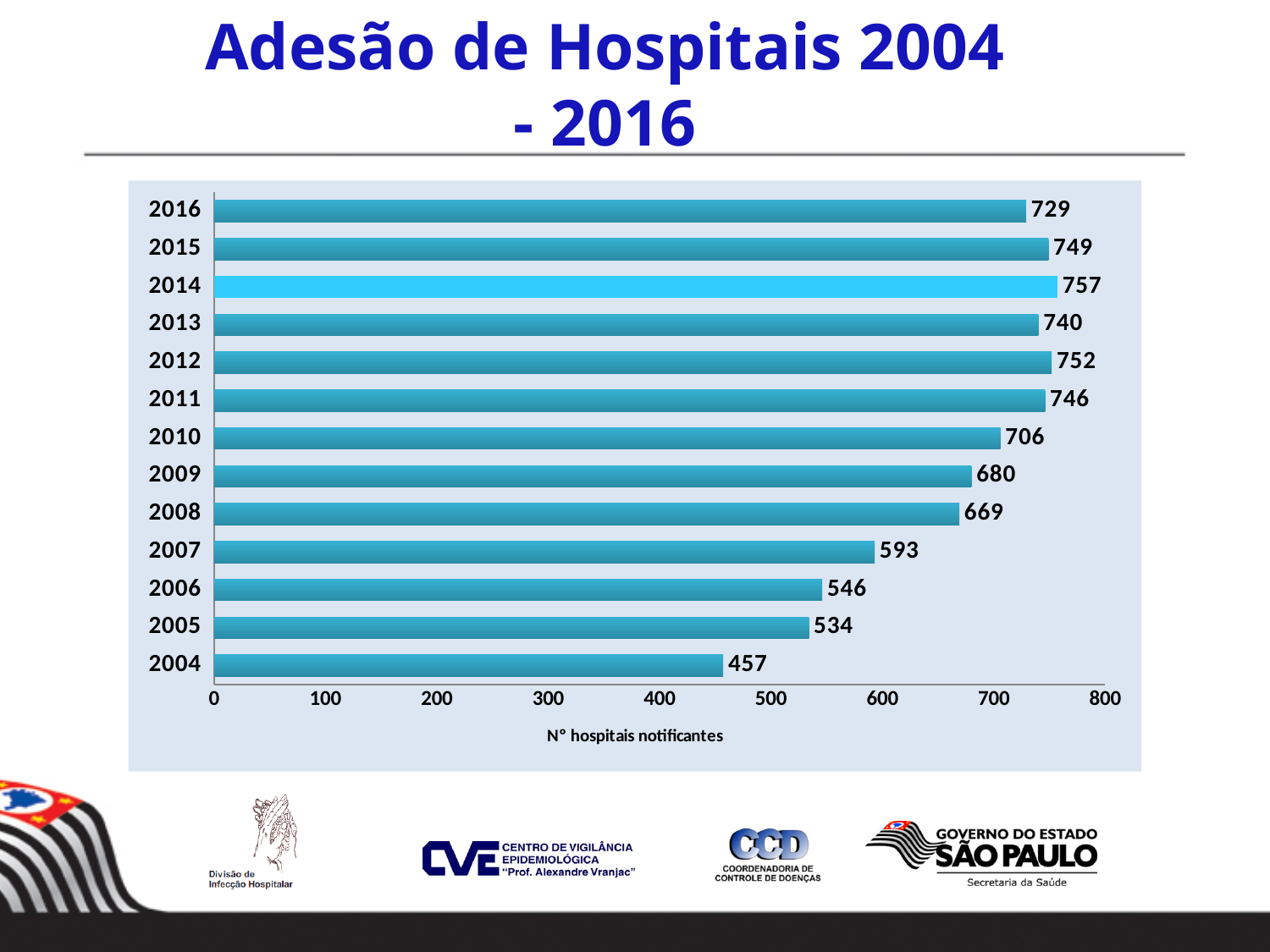
Which year has the highest number of notifying hospitals? 2014 What kind of chart is shown on the slide? Bar chart Which is larger, the value for 2010 or the value for 2009? 2010 What is the value shown for 2016? 729 What is the value shown for 2014? 757 What is the difference between the values for 2016 and 2004? 272 What is the number of notifying hospitals in 2004? 457 What is the difference between the values for 2014 and 2013? 17 What is the label of the horizontal axis? N° hospitais notificantes Is the value for 2007 greater or less than 500? greater Which year has the lowest number of notifying hospitals? 2004 How many years are shown in the chart? 13